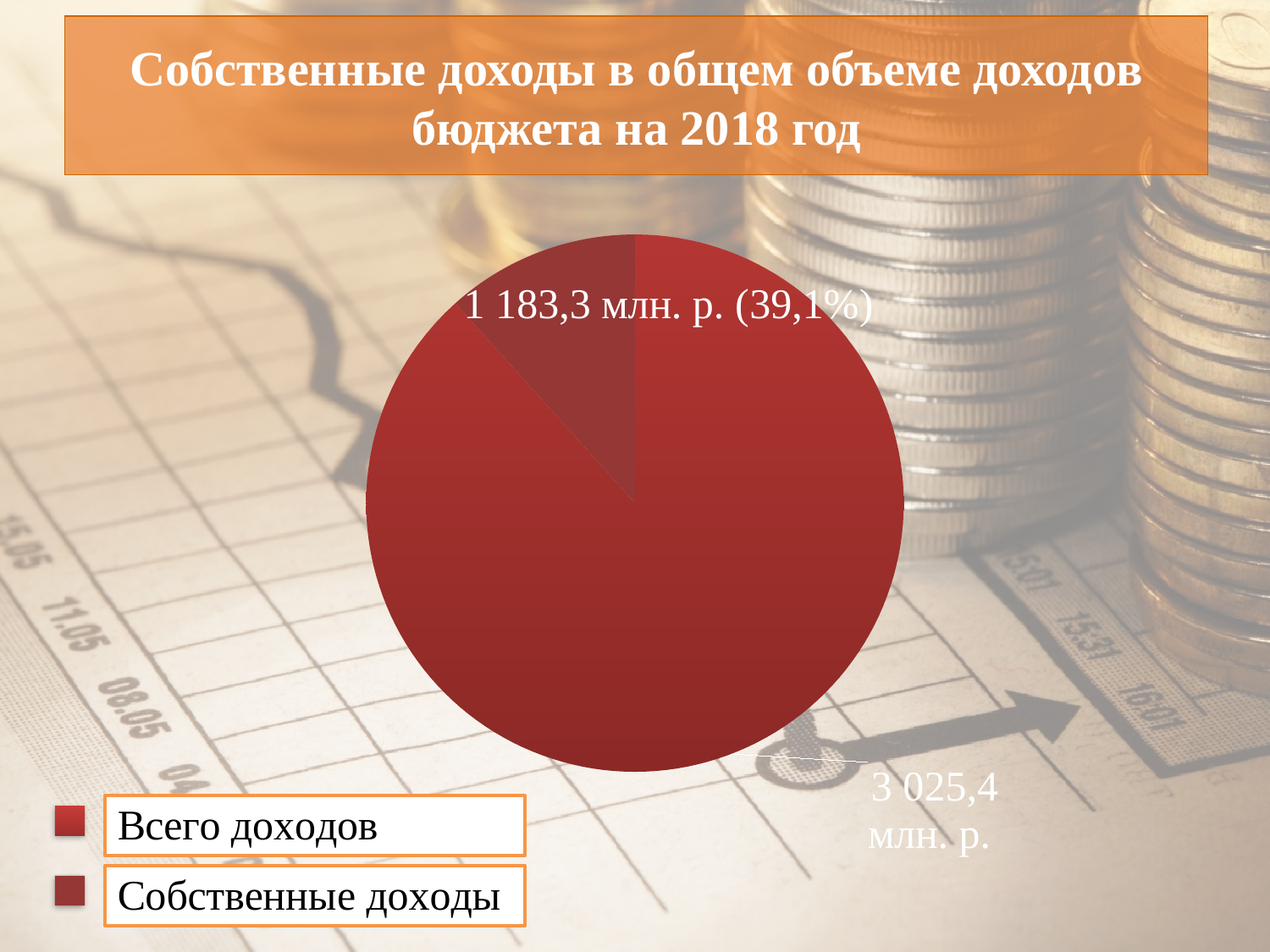
What value is shown for Всего доходов? 3 025,4 млн. р. How many slices does the pie chart have? 2 Which is larger, Всего доходов or Собственные доходы? Всего доходов How many entries does the legend list? 2 What is the difference between Всего доходов and Собственные доходы? 1 842,1 млн. р. Which slice of the pie is the smallest? Собственные доходы Which slice of the pie is the largest? Всего доходов What kind of chart is shown on the slide? pie chart What value is shown for Собственные доходы? 1 183,3 млн. р. Which year does the chart refer to? 2018 What is the title of the slide? Собственные доходы в общем объеме доходов бюджета на 2018 год What percentage share is printed for the Собственные доходы slice? 39,1%